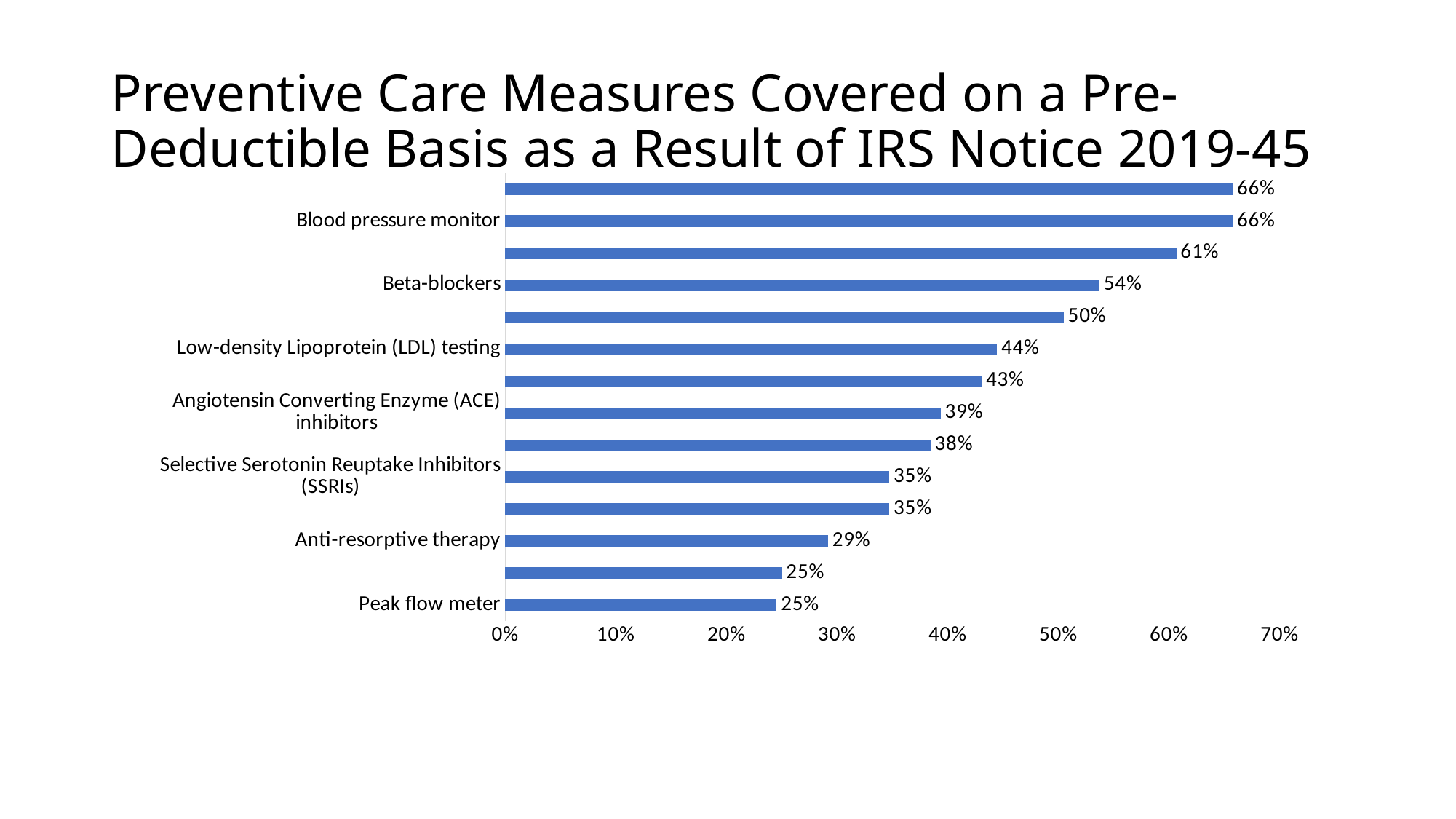
What kind of chart is shown on the slide? bar chart What is the highest value shown on the chart? 66% What is the value for Blood pressure monitor? 66% What is the lowest value shown on the chart? 25% What is the value for Low-density Lipoprotein (LDL) testing? 44% What is the value for Beta-blockers? 54% What is the difference between the values for Blood pressure monitor and Peak flow meter? 41% What is the value for Angiotensin Converting Enzyme (ACE) inhibitors? 39% Is the value for Beta-blockers greater or less than 50%? greater What is the value for Peak flow meter? 25% How many bars are plotted on the chart? 14 Which is larger, the value for Angiotensin Converting Enzyme (ACE) inhibitors or for Selective Serotonin Reuptake Inhibitors (SSRIs)? Angiotensin Converting Enzyme (ACE) inhibitors